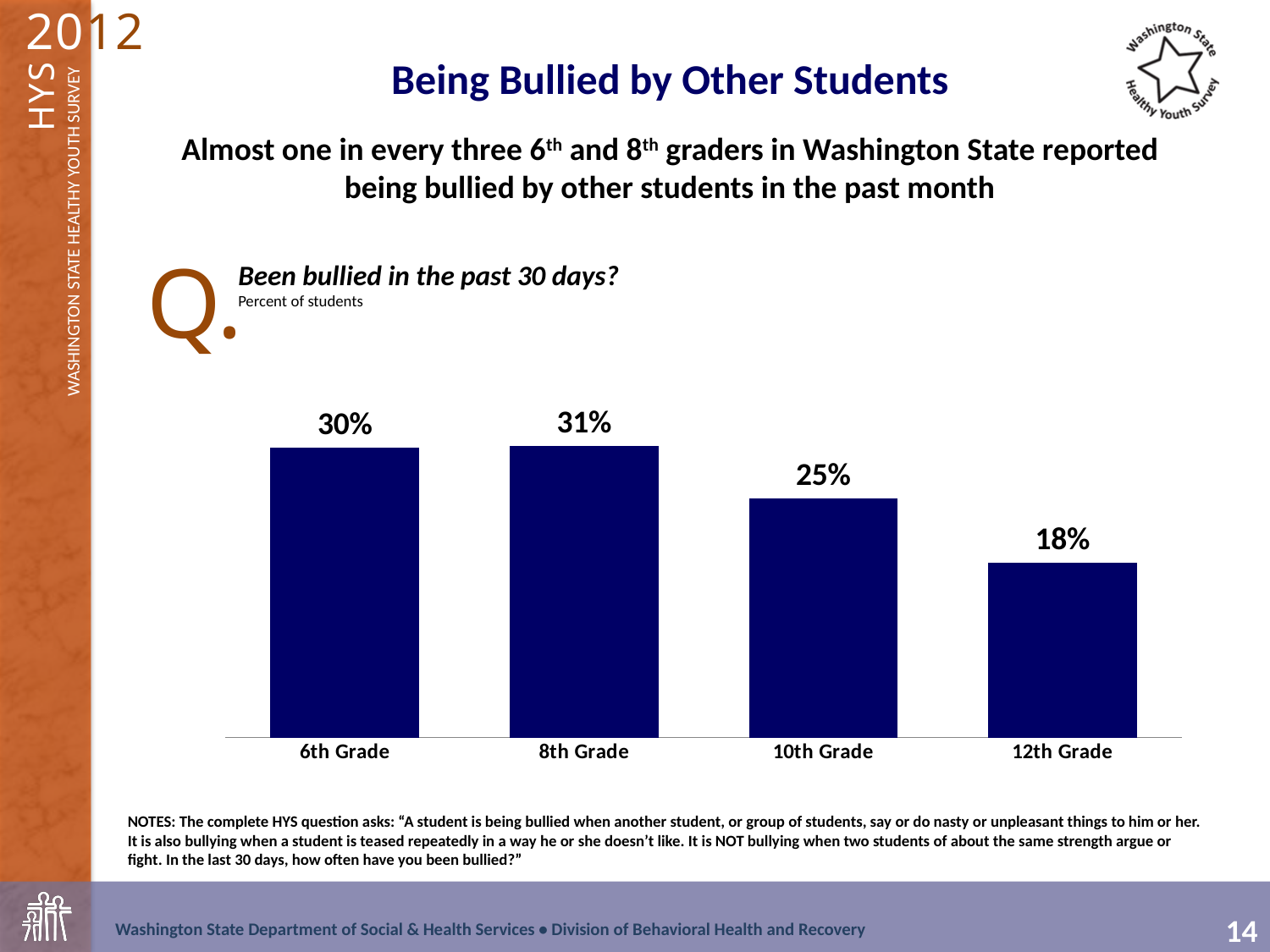
What percent of 10th graders reported being bullied in the past 30 days? 25% Do the values generally rise or fall from 8th Grade to 12th Grade? Fall What kind of chart is shown on the slide? Bar chart What percent of 12th graders reported being bullied in the past 30 days? 18% What is the difference in percentage points between 6th Grade and 10th Grade? 5 What is the difference in percentage points between 8th Grade and 12th Grade? 13 Which grade has the lowest percent of students reporting being bullied? 12th Grade What percent of 8th graders reported being bullied in the past 30 days? 31% Which is larger, the value for 10th Grade or the value for 12th Grade? 10th Grade How many grade categories are shown in the chart? 4 Which grade has the highest percent of students reporting being bullied? 8th Grade What percent of 6th graders reported being bullied in the past 30 days? 30%